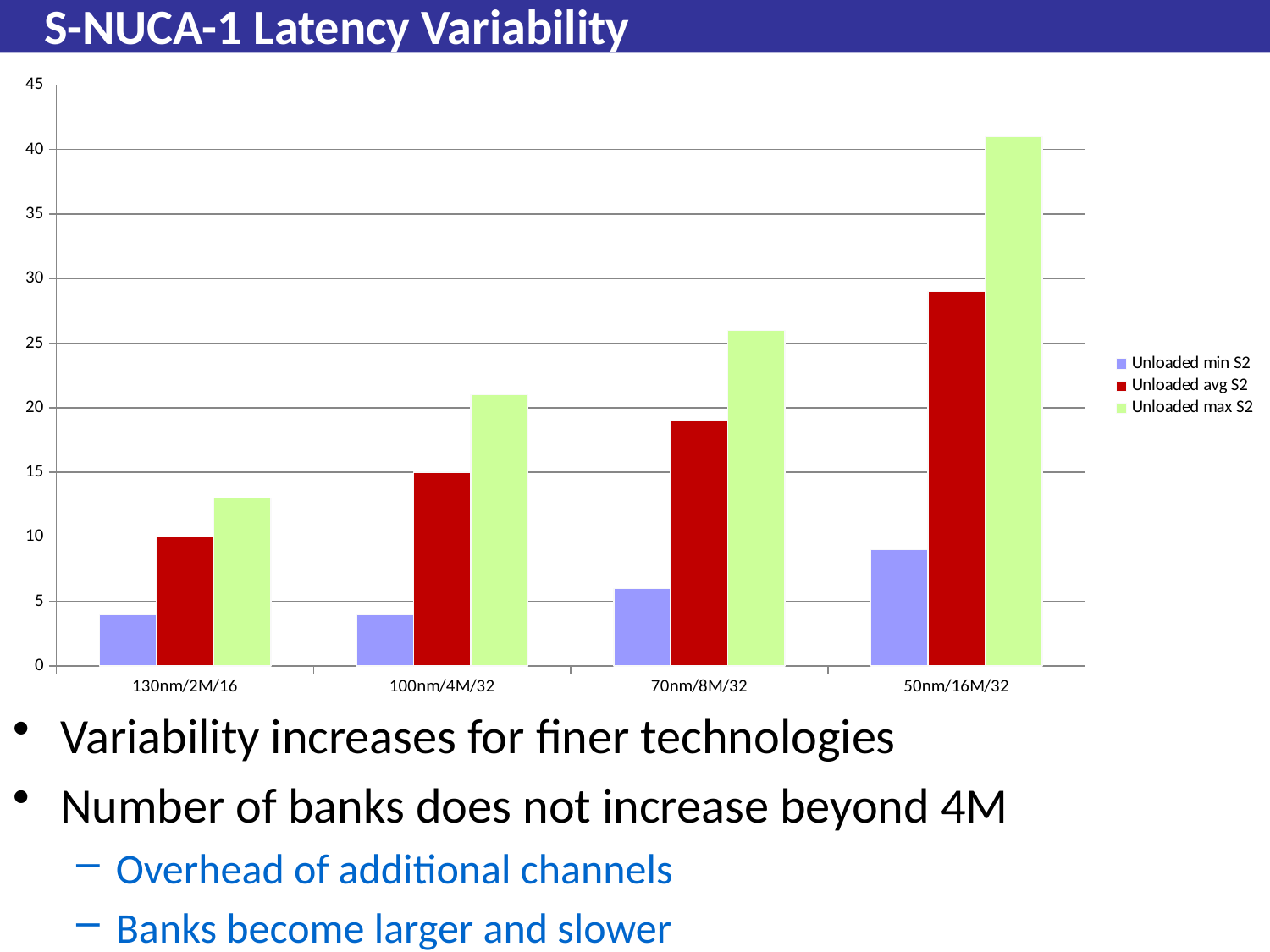
What is the Unloaded avg S2 value for 100nm/4M/32? 15 Which configuration has the lowest Unloaded avg S2 value? 130nm/2M/16 Is the Unloaded max S2 value for 70nm/8M/32 greater or less than 25? greater How many technology configurations are shown on the x axis? 4 How many series does the legend list? 3 Which configuration has the highest Unloaded max S2 value? 50nm/16M/32 Do the Unloaded max S2 values rise or fall from 130nm/2M/16 to 50nm/16M/32? rise Is the Unloaded min S2 value for 50nm/16M/32 greater or less than 10? less What kind of chart is shown on the slide? bar chart Which is larger: the Unloaded avg S2 value for 70nm/8M/32 or the Unloaded max S2 value for 100nm/4M/32? Unloaded max S2 for 100nm/4M/32 Is the Unloaded max S2 value for 50nm/16M/32 greater or less than 40? greater What is the Unloaded avg S2 value for 130nm/2M/16? 10